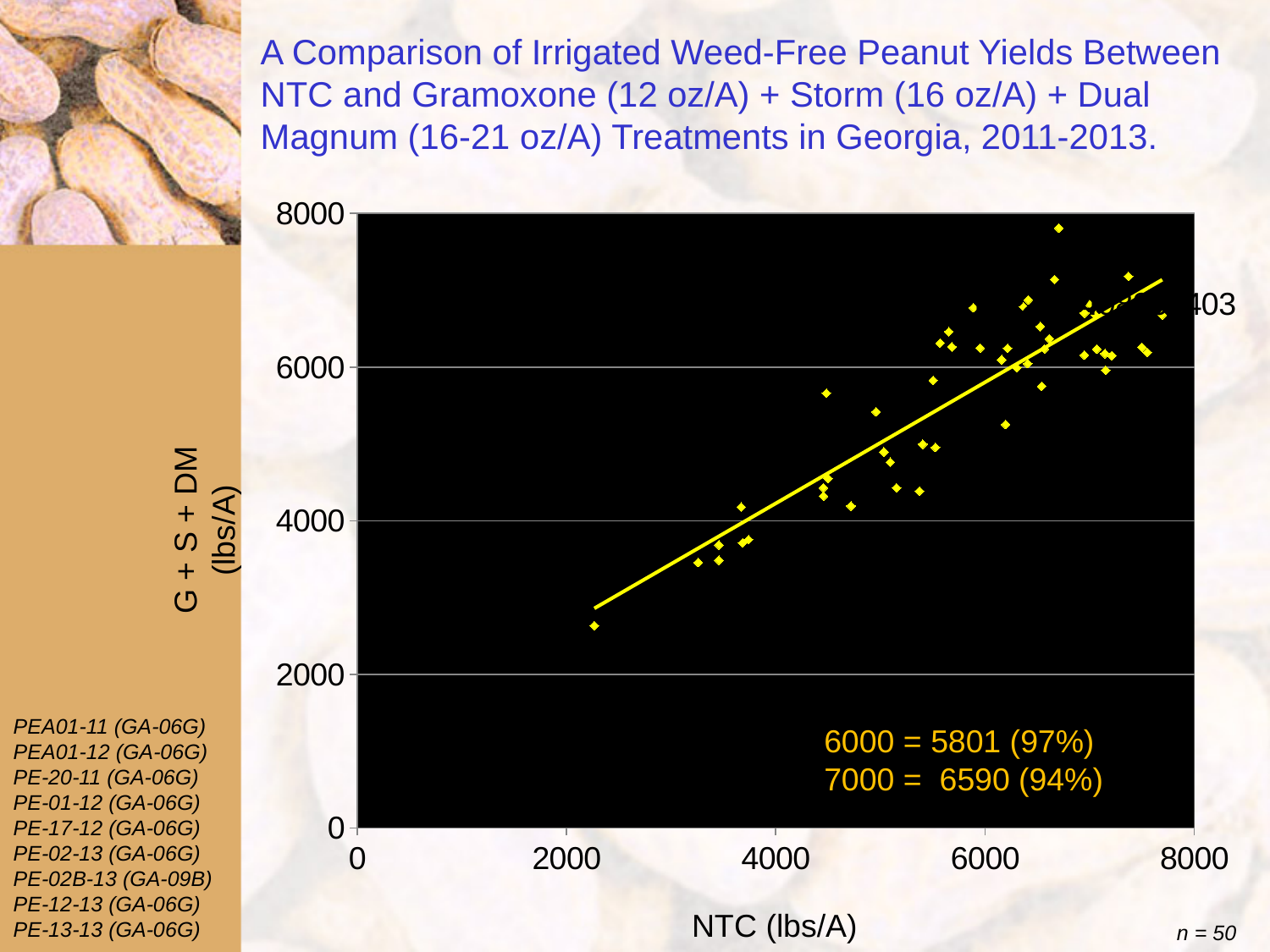
What kind of chart is shown on the slide? Scatter plot Are there any plotted points with an NTC yield less than 2000? No What is the highest value shown on the y axis? 8000 How many data points does the chart report (n)? 50 According to the annotation on the chart, what G + S + DM yield corresponds to an NTC yield of 7000? 6590 (94%) Is the G + S + DM value of the highest plotted point greater or less than 6000? greater Do the plotted G + S + DM yields generally rise or fall as NTC yield increases along the x axis? Rise What is the label of the x axis? NTC (lbs/A) In which state and years were the yield comparisons in the chart conducted? Georgia, 2011-2013 Is the G + S + DM value of the lowest plotted point (near NTC 2200) greater or less than 4000? less According to the annotation on the chart, what G + S + DM yield corresponds to an NTC yield of 6000? 5801 (97%)